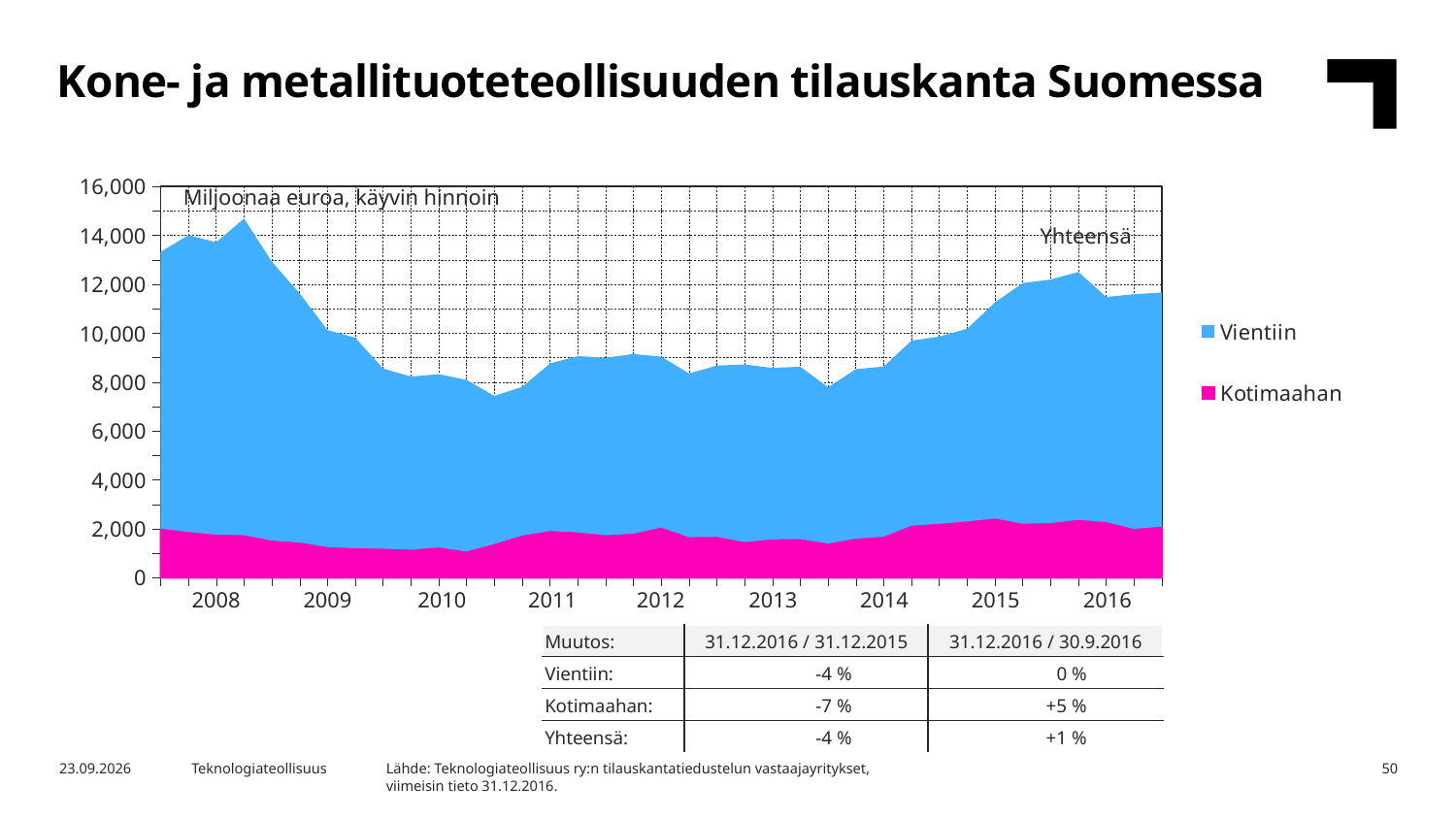
Is the peak total value in 2008 greater or less than 14,000? greater Is the Kotimaahan value at any point greater or less than 4,000? less How many series does the chart legend list? 2 What unit label is printed inside the chart area? Miljoonaa euroa, käyvin hinnoin How many year labels are shown on the x axis? 9 Does the total order backlog rise or fall from 2013 to 2015? rise In which year does the total order backlog (Yhteensä) reach its highest level? 2008 What kind of chart is shown on the slide? Stacked area chart Which two series are listed in the chart legend? Vientiin and Kotimaahan Does the total order backlog rise or fall from 2008 to 2010? fall Is the total value in 2010 greater or less than 10,000? less Which series is larger throughout the chart, Vientiin or Kotimaahan? Vientiin